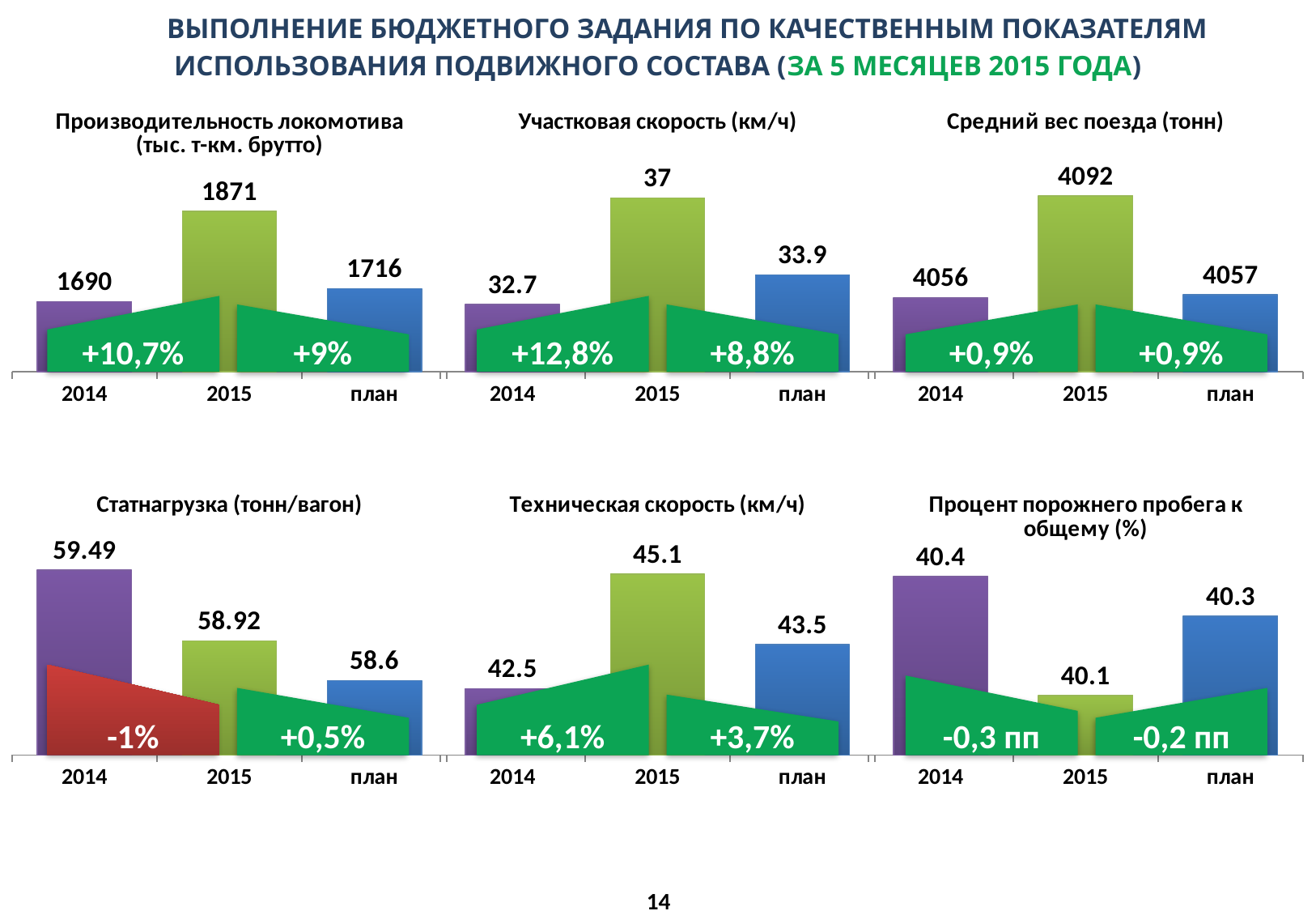
In the chart titled "Статнагрузка (тонн/вагон)", what is the value for 2014? 59.49 How many charts are shown on the slide? 6 In the chart titled "Производительность локомотива (тыс. т-км. брутто)", what is the value for 2015? 1871 In the chart titled "Техническая скорость (км/ч)", what is the difference between the 2015 value and the 2014 value? 2.6 In the chart titled "Процент порожнего пробега к общему (%)", which is larger, the value for 2014 or the value for план? 2014 What kind of chart is the one titled "Средний вес поезда (тонн)"? bar chart In the chart titled "Производительность локомотива (тыс. т-км. брутто)", what is the difference between the 2015 value and the план value? 155 In the chart titled "Участковая скорость (км/ч)", what is the value for план? 33.9 In the chart titled "Средний вес поезда (тонн)", which category has the highest value? 2015 In the chart titled "Статнагрузка (тонн/вагон)", which category has the lowest value? план How many categories are shown on the x axis of the chart titled "Участковая скорость (км/ч)"? 3 In the chart titled "Процент порожнего пробега к общему (%)", what is the value for 2015? 40.1